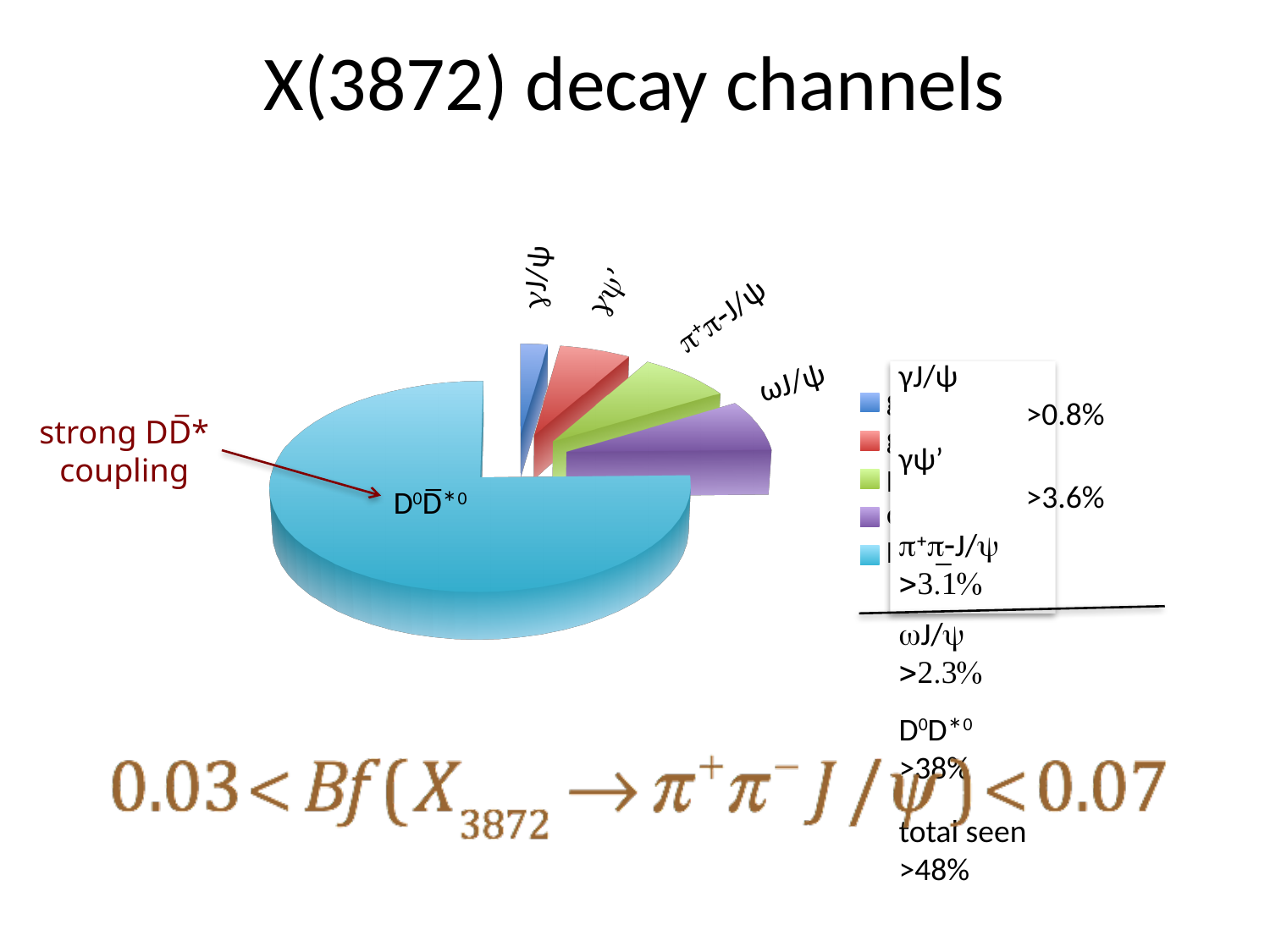
What value is printed on the slide for the γJ/ψ channel? >0.8% Which decay channel has the largest slice of the pie? D0D*0 Which slice is larger, D0D*0 or ωJ/ψ? D0D*0 How many slices does the pie chart have? 5 Which slice does the 'strong DD̄* coupling' arrow point to? D0D*0 Which decay channel has the smallest slice of the pie? γJ/ψ What is the title of the chart? X(3872) decay channels What value is printed on the slide for the D0D*0 channel? >38% What value is printed on the slide for the ωJ/ψ channel? >2.3% Which slice is larger, γψ' or γJ/ψ? γψ' What value is printed on the slide for 'total seen'? >48% What kind of chart is shown on the slide? pie chart